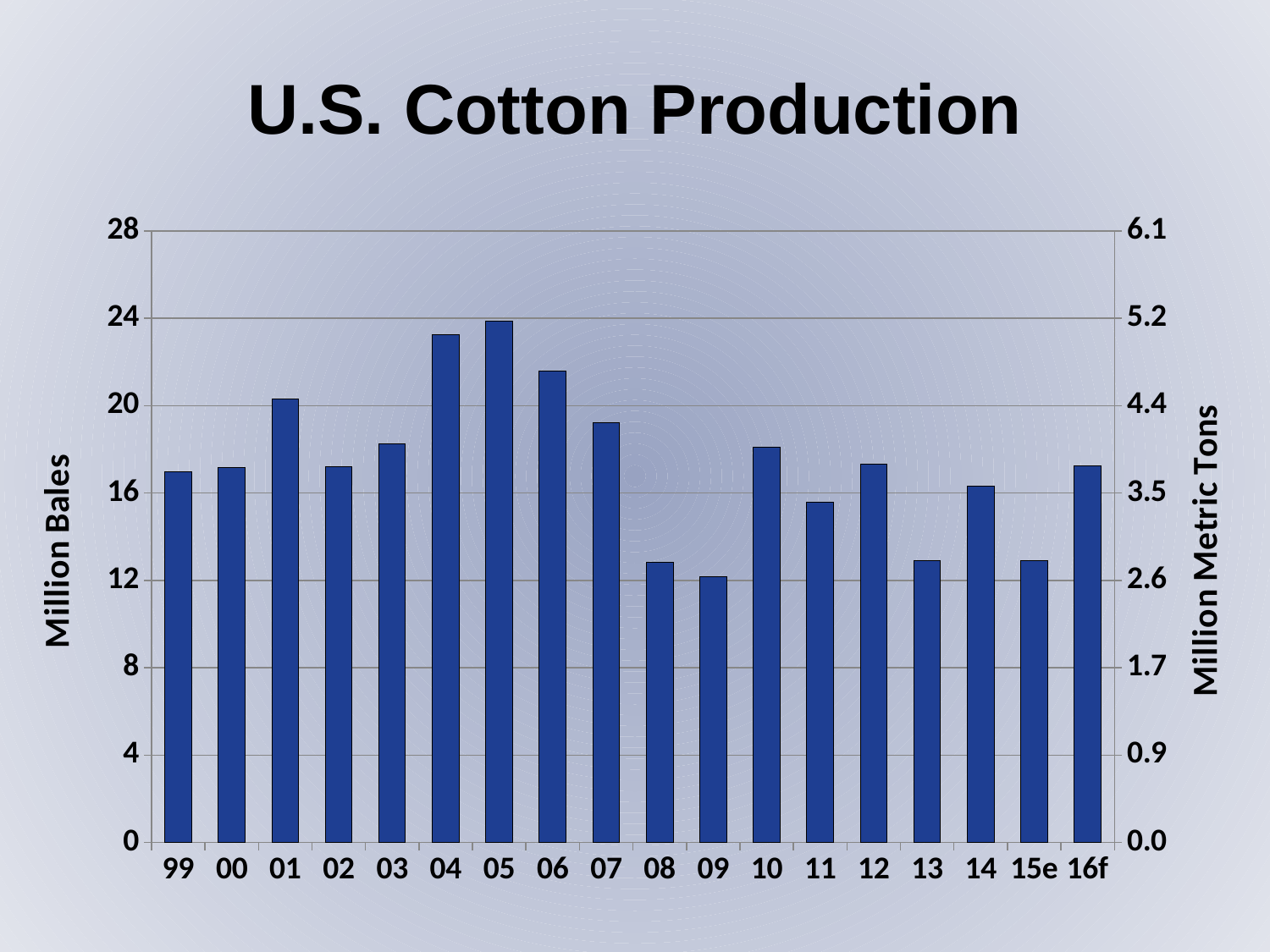
Is the value for 05 greater or less than 20 million bales? greater How many bars (years) are shown in the chart? 18 Which year has higher production, 04 or 06? 04 Which year has higher production, 10 or 11? 10 Which year has the lowest cotton production? 09 Do the values rise or fall from 05 to 09? fall Which year has the highest cotton production? 05 What type of chart is shown on the slide? bar chart What is the title of the chart? U.S. Cotton Production Is the value for 09 greater or less than 16 million bales? less What is the label of the left vertical axis? Million Bales Is the value for 07 greater or less than 16 million bales? greater